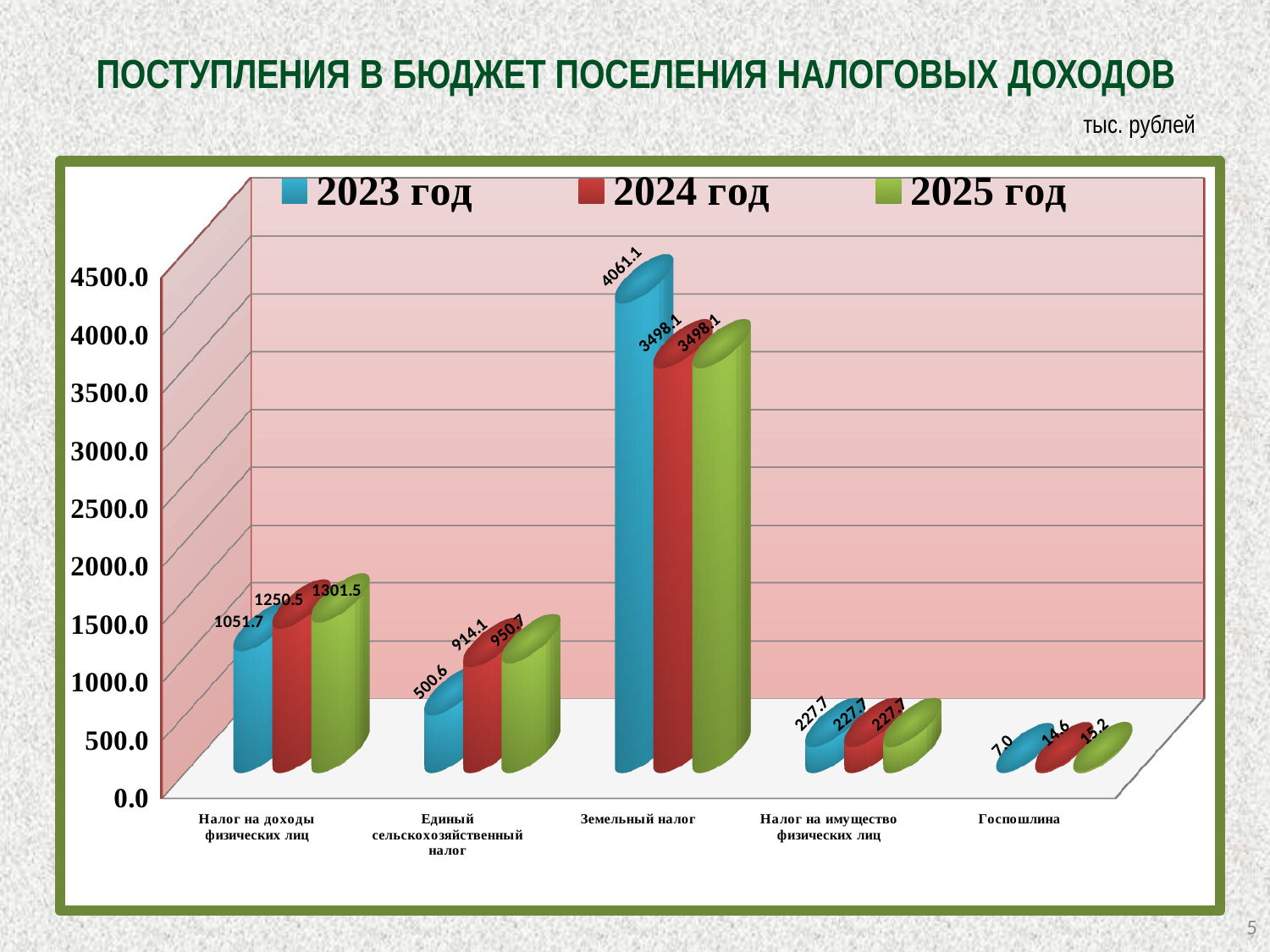
Which category has the lowest value in 2023 год? Госпошлина What is the value for Налог на доходы физических лиц in 2023 год? 1051.7 Which is larger for Единый сельскохозяйственный налог: the 2023 год value or the 2025 год value? 2025 год Which category has the highest value in 2024 год? Земельный налог What kind of chart is shown on the slide? Bar chart What unit is stated above the chart? тыс. рублей What is the difference between the 2025 год and 2023 год values for Налог на доходы физических лиц? 249.8 How many series does the legend list? 3 How many categories are shown on the x axis? 5 What is the value for Госпошлина in 2025 год? 15.2 What is the value for Земельный налог in 2023 год? 4061.1 What is the value for Единый сельскохозяйственный налог in 2024 год? 914.1